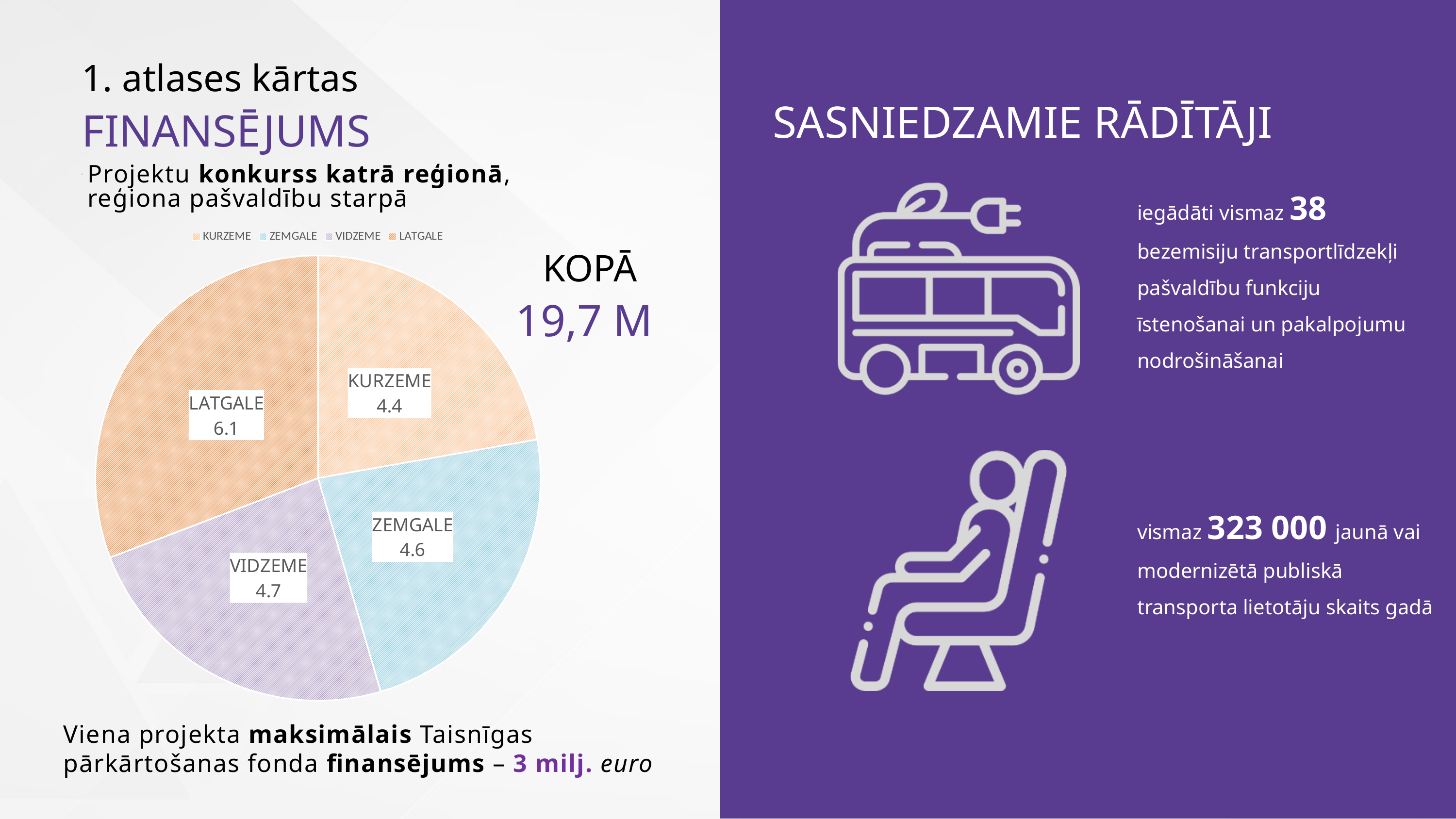
How many slices does the pie chart have? 4 What kind of chart is shown on the slide? pie chart What is the difference between the values for LATGALE and ZEMGALE? 1.5 Which is larger in the pie chart, LATGALE or VIDZEME? LATGALE What is the value shown for ZEMGALE in the pie chart? 4.6 Which region has the largest slice in the pie chart? LATGALE What is the value shown for VIDZEME in the pie chart? 4.7 What is the value shown for KURZEME in the pie chart? 4.4 What is the value shown for LATGALE in the pie chart? 6.1 Which region has the smallest value in the pie chart? KURZEME What total (KOPĀ) is shown next to the pie chart? 19,7 M What is the difference between the values for LATGALE and KURZEME? 1.7